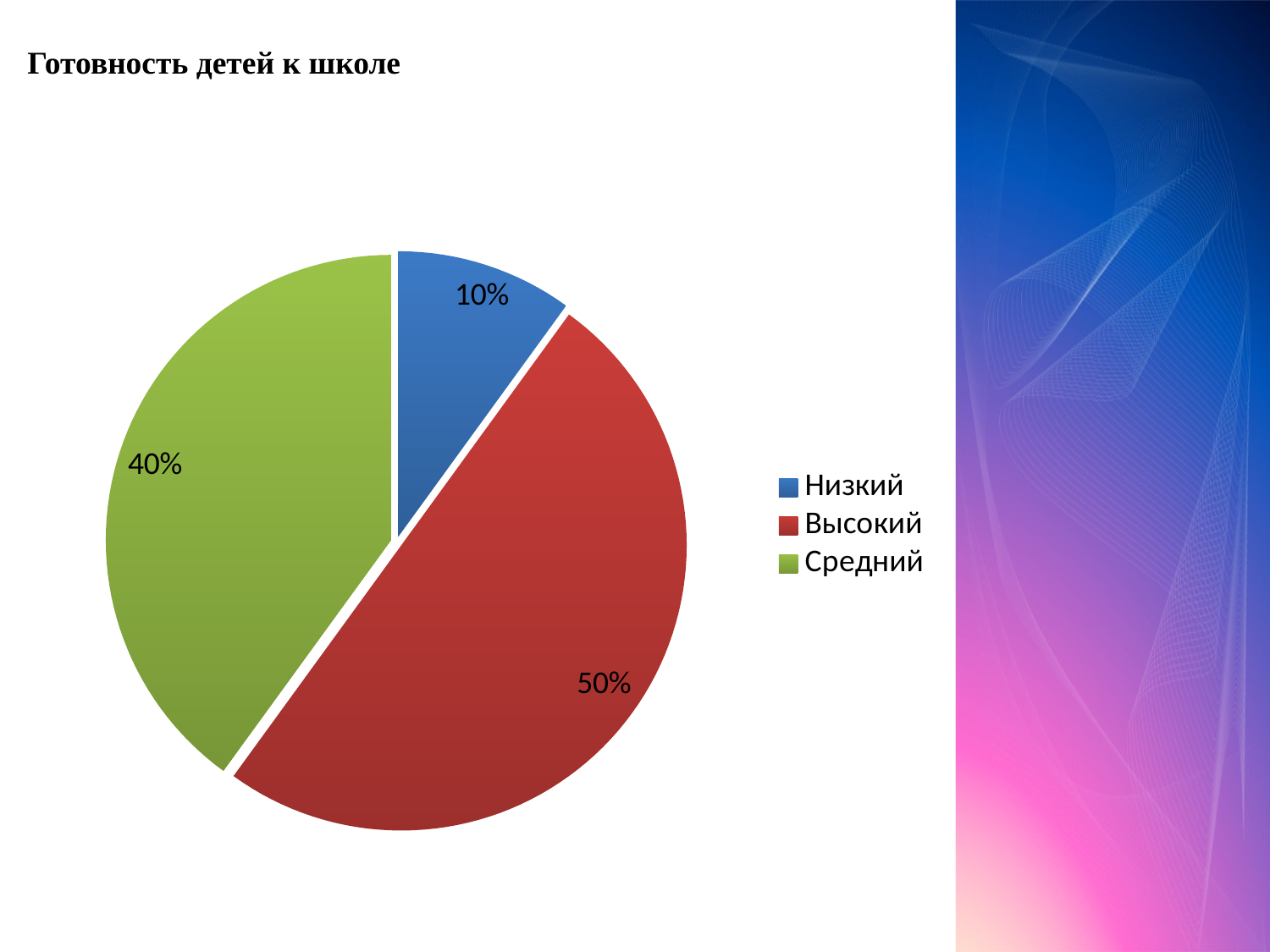
What is the difference in percentage points between Высокий and Средний? 10% What share of the pie does Средний represent? 40% Which category has the largest slice of the pie? Высокий What share of the pie does Низкий represent? 10% Which colour represents Высокий in the legend? Red Which is larger, the share for Средний or the share for Низкий? Средний What kind of chart is shown on the slide? Pie chart Which category has the smallest slice of the pie? Низкий What share of the pie does Высокий represent? 50% What is the difference in percentage points between Средний and Низкий? 30% How many categories does the pie chart show? 3 What is the title of the slide above the chart? Готовность детей к школе